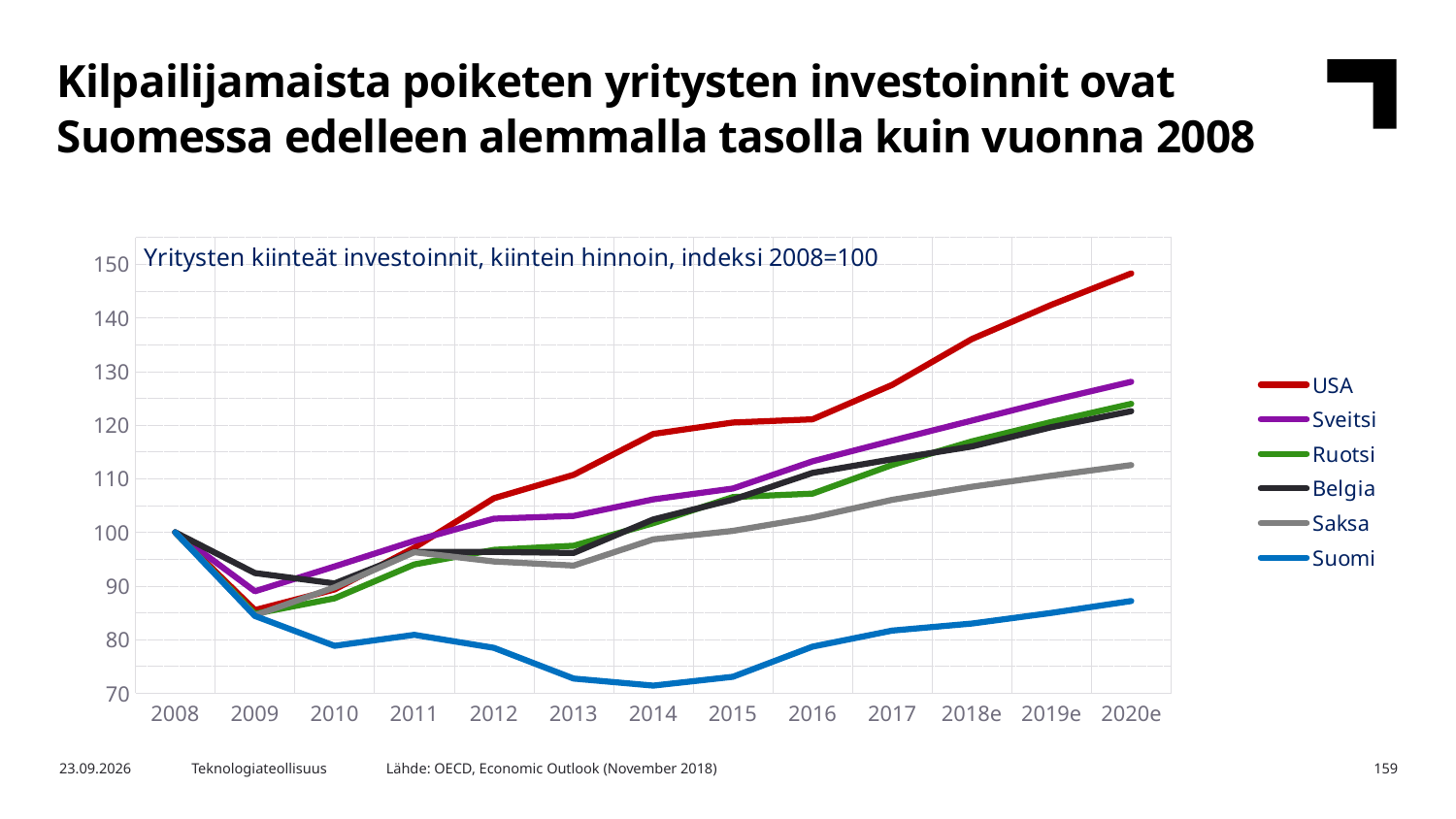
Which country has the highest index value in 2020e? USA Which country has the lowest index value in 2020e? Suomi Does the value for Suomi rise or fall from 2008 to 2014? fall How many years are shown on the x axis? 13 What kind of chart is shown on the slide? line chart How many series does the legend list? 6 What is the title of the chart? Yritysten kiinteät investoinnit, kiintein hinnoin, indeksi 2008=100 Is the value for Suomi in 2014 greater or less than 80? less What is the index value for all countries in 2008? 100 Is the value for Sveitsi in 2020e greater or less than 120? greater Is the value for USA in 2020e greater or less than 140? greater Which is larger in 2016, the value for USA or the value for Suomi? USA